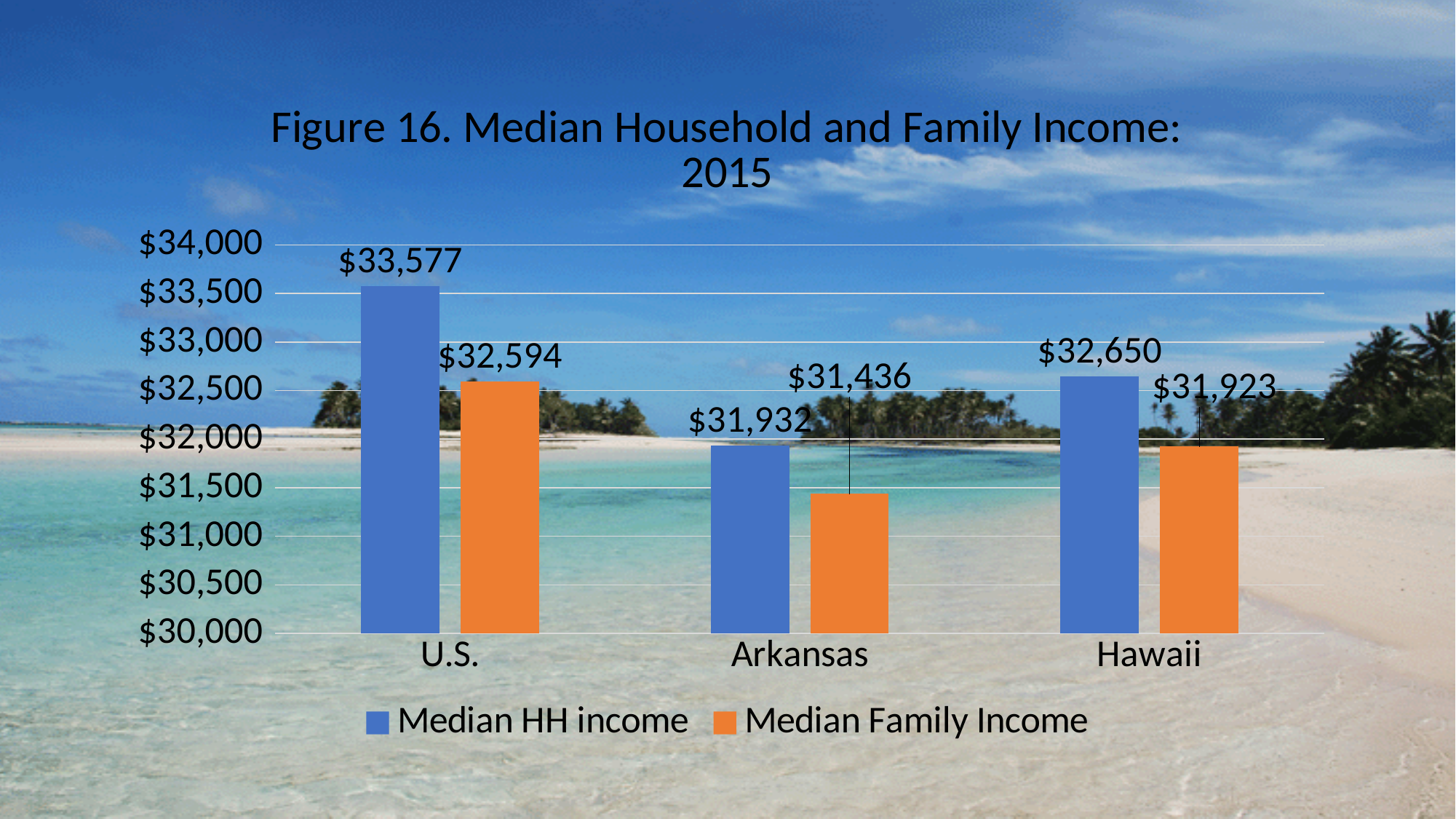
What is the Median Family Income for Arkansas? $31,436 What is the difference between the Median HH income and the Median Family Income for the U.S.? $983 Which category has the lowest Median Family Income? Arkansas What is the Median HH income for Hawaii? $32,650 What is the Median HH income for the U.S.? $33,577 What kind of chart is shown on the slide? Bar chart Which category has the highest Median HH income? U.S. How many categories are shown on the x axis? 3 Is the Median Family Income for the U.S. greater or less than $32,500? greater Which is larger: the Median HH income for Arkansas or the Median Family Income for Hawaii? Median HH income for Arkansas What is the Median Family Income for Hawaii? $31,923 How many series does the legend list? 2